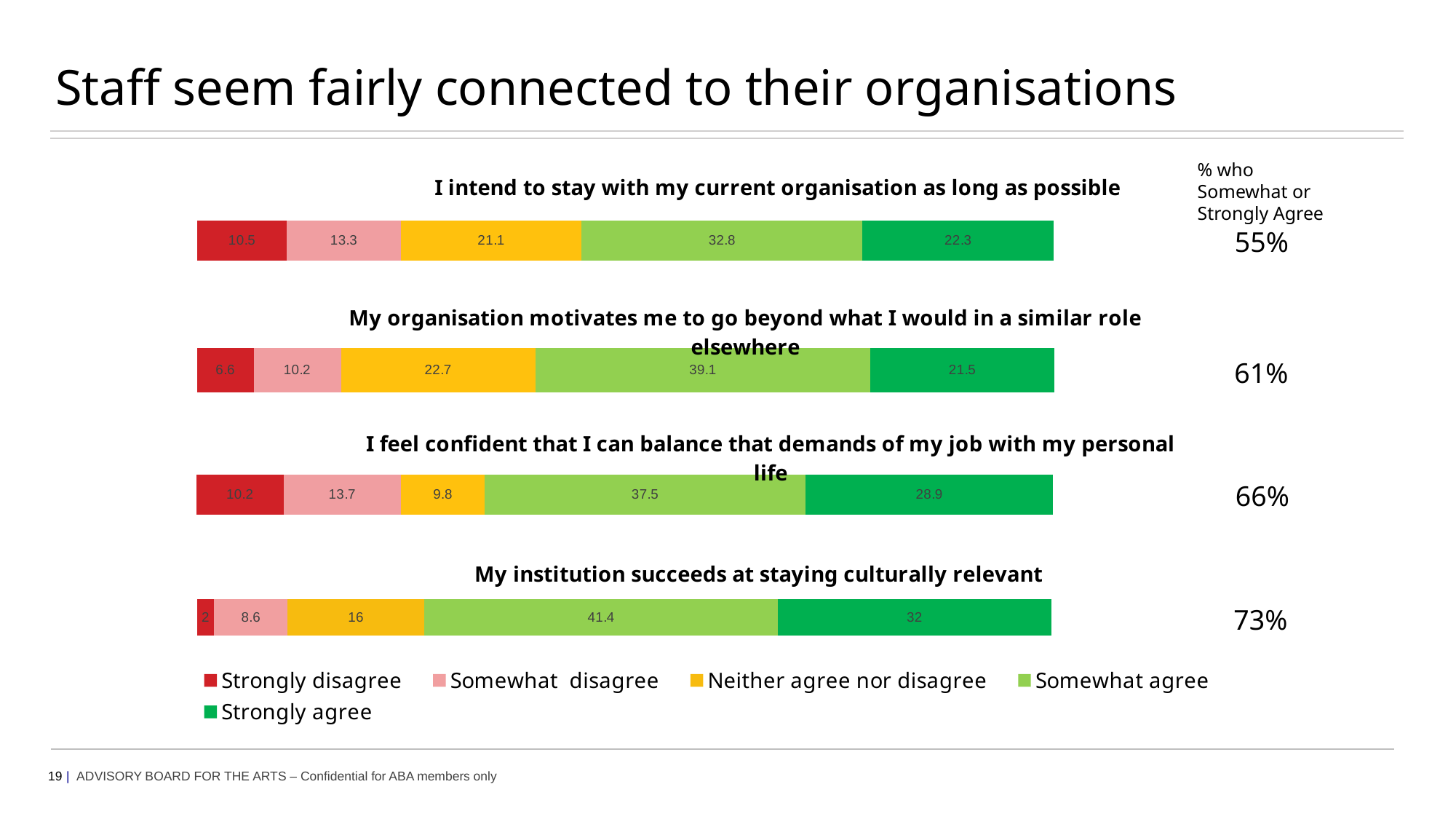
In the chart 'My institution succeeds at staying culturally relevant', what is the value for Strongly agree? 32 In the chart 'My institution succeeds at staying culturally relevant', which response category has the highest value? Somewhat agree Which colour represents Strongly disagree in the legend? Red In the chart 'I intend to stay with my current organisation as long as possible', what is the value for Somewhat agree? 32.8 In the chart 'My organisation motivates me to go beyond what I would in a similar role elsewhere', what is the value for Strongly disagree? 6.6 How many response categories does the legend list? 5 In the chart 'I feel confident that I can balance that demands of my job with my personal life', what is the value for Neither agree nor disagree? 9.8 In the chart 'I feel confident that I can balance that demands of my job with my personal life', which response category has the lowest value? Neither agree nor disagree In the chart 'My organisation motivates me to go beyond what I would in a similar role elsewhere', which is larger: Somewhat disagree or Neither agree nor disagree? Neither agree nor disagree What is the '% who Somewhat or Strongly Agree' shown for the chart 'My institution succeeds at staying culturally relevant'? 73% What kind of chart is used to show the survey responses on this slide? Stacked bar chart In the chart 'I intend to stay with my current organisation as long as possible', what is the difference between the Somewhat agree and Strongly agree values? 10.5